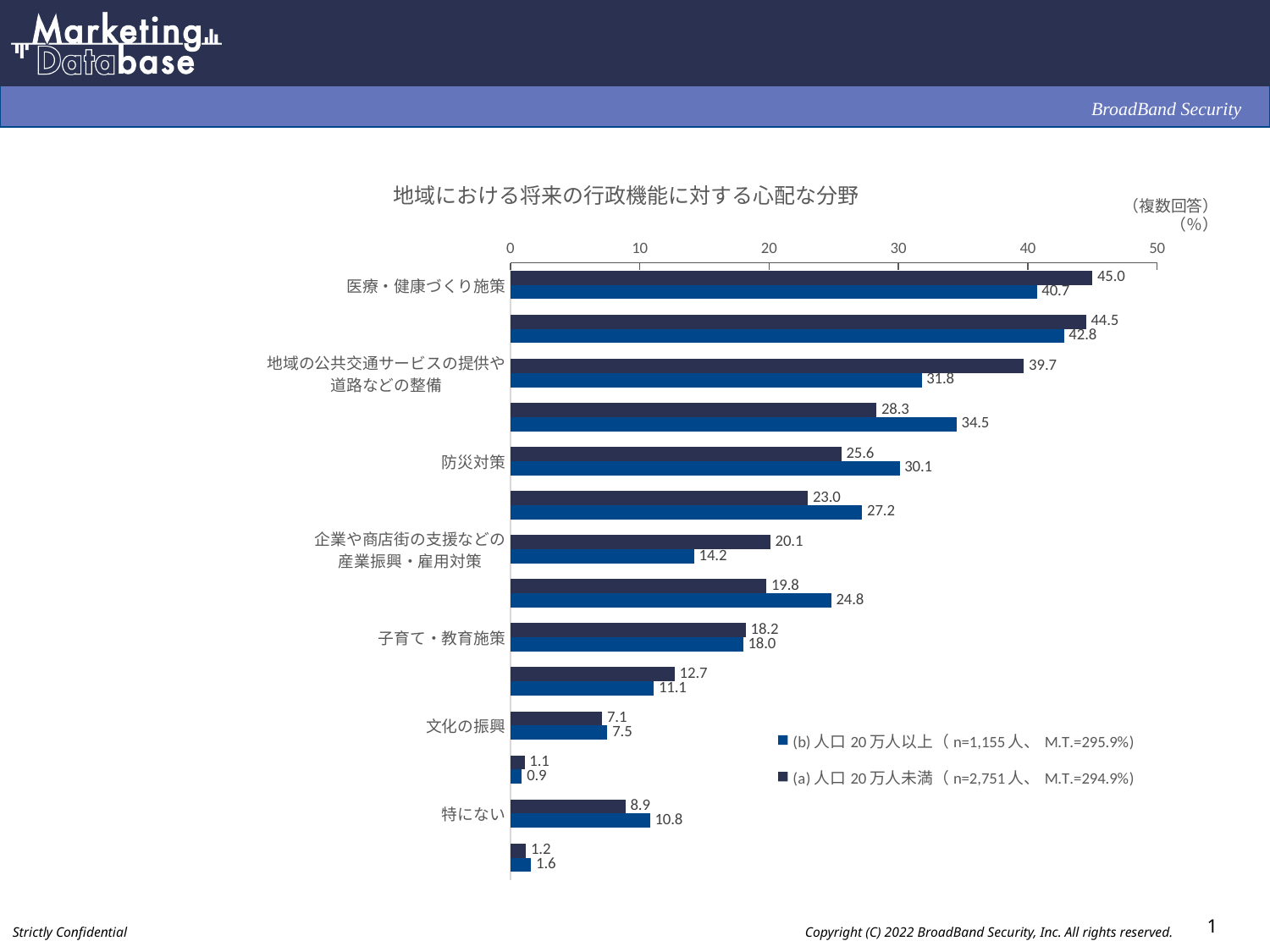
What is the value of the dark navy (upper) bar for 医療・健康づくり施策? 45.0 What kind of chart is shown on the slide? bar chart How many series does the legend list? 2 What is the value of the blue (lower) bar for 防災対策? 30.1 What is the title of the chart? 地域における将来の行政機能に対する心配な分野 What is the difference between the dark navy bar and the blue bar for 医療・健康づくり施策? 4.3 For 防災対策, which bar is larger, the dark navy (upper) bar or the blue (lower) bar? the blue (lower) bar What is the value of the dark navy (upper) bar for 地域の公共交通サービスの提供や道路などの整備? 39.7 What is the value of the blue (lower) bar for 医療・健康づくり施策? 40.7 Which labeled category has the highest value in the chart? 医療・健康づくり施策 Is the value of the blue (lower) bar for 文化の振興 greater or less than 10? less How many category labels are shown on the vertical axis of the chart? 7